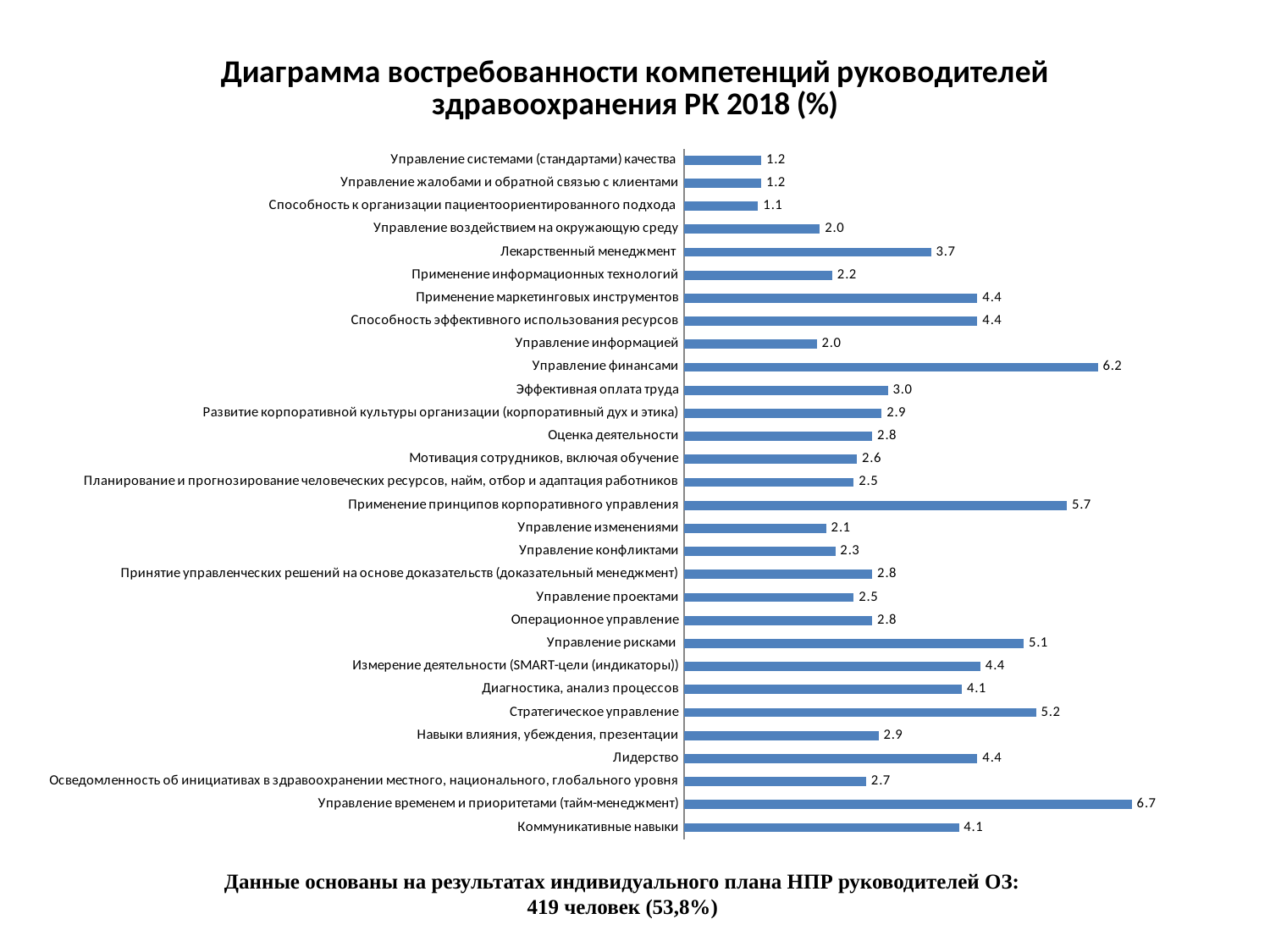
Which competency has the highest value? Управление временем и приоритетами (тайм-менеджмент) What is the value for Управление финансами? 6.2 What is the difference between the values for Применение принципов корпоративного управления and Коммуникативные навыки? 1.6 What is the title of the chart? Диаграмма востребованности компетенций руководителей здравоохранения РК 2018 (%) What is the value for Управление временем и приоритетами (тайм-менеджмент)? 6.7 What is the difference between the values for Управление финансами and Управление рисками? 1.1 What is the value for Лекарственный менеджмент? 3.7 Which competency has the lowest value? Способность к организации пациентоориентированного подхода What is the value for Стратегическое управление? 5.2 What type of chart is shown on the slide? bar chart How many competencies (categories) are plotted in the chart? 30 Which is larger, the value for Лидерство or the value for Диагностика, анализ процессов? Лидерство